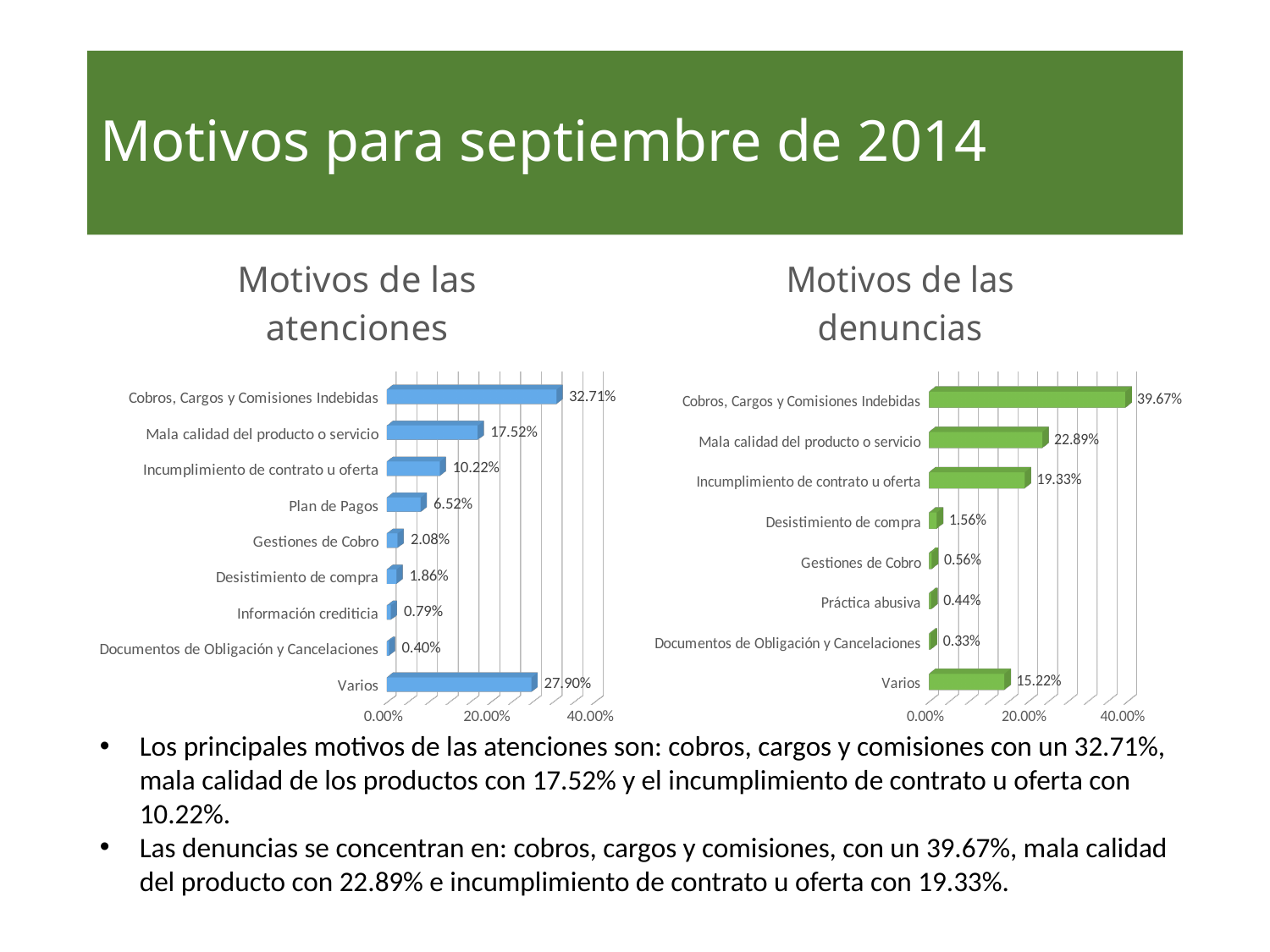
In the 'Motivos de las atenciones' chart, what is the difference between Cobros, Cargos y Comisiones Indebidas and Varios? 4.81% In the 'Motivos de las denuncias' chart, which category has the lowest value? Documentos de Obligación y Cancelaciones In the 'Motivos de las atenciones' chart, what is the value for Gestiones de Cobro? 2.08% What kind of chart is 'Motivos de las denuncias'? Bar chart In the 'Motivos de las atenciones' chart, what is the value for Mala calidad del producto o servicio? 17.52% In the 'Motivos de las denuncias' chart, which is larger: Mala calidad del producto o servicio or Varios? Mala calidad del producto o servicio In the 'Motivos de las atenciones' chart, is the value for Plan de Pagos greater or less than 20.00%? less In the 'Motivos de las atenciones' chart, which category has the highest value? Cobros, Cargos y Comisiones Indebidas What colour are the bars in the 'Motivos de las atenciones' chart? Blue How many categories are shown in the 'Motivos de las denuncias' chart? 8 How many categories are shown in the 'Motivos de las atenciones' chart? 9 In the 'Motivos de las denuncias' chart, what is the value for Incumplimiento de contrato u oferta? 19.33%